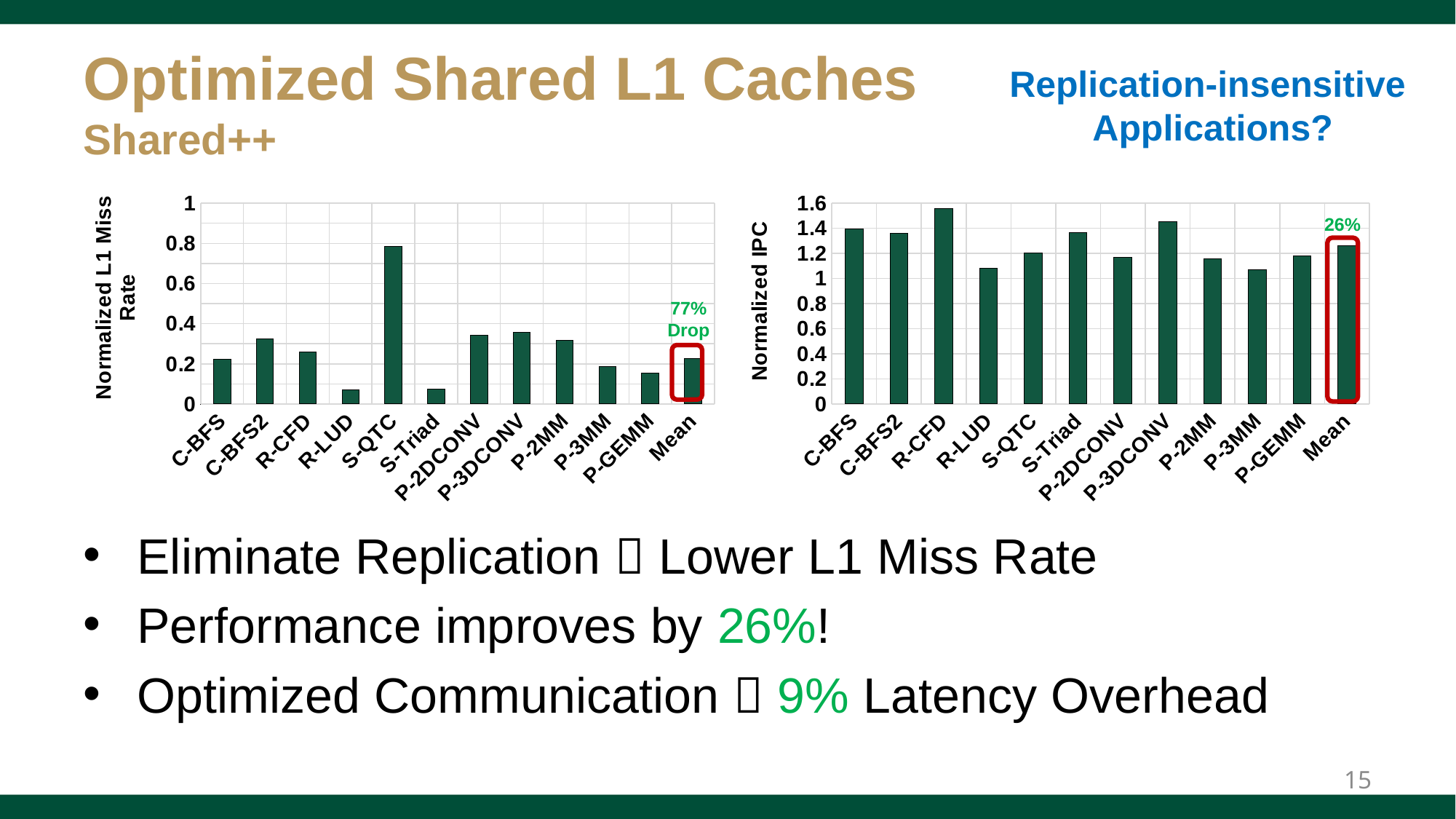
In the right chart (Normalized IPC), which is larger, the value for R-CFD or the value for P-3MM? R-CFD How many categories are shown on the x axis of the right chart (Normalized IPC)? 12 What kind of chart is the left chart (Normalized L1 Miss Rate)? bar chart In the right chart (Normalized IPC), is the value for R-LUD greater or less than 1.2? less In the right chart (Normalized IPC), which category has the highest value? R-CFD In the left chart (Normalized L1 Miss Rate), is the value for S-QTC greater or less than 0.6? greater What percentage is annotated above the Mean bar in the right chart (Normalized IPC)? 26% In the left chart (Normalized L1 Miss Rate), which is larger, the value for S-QTC or the value for C-BFS? S-QTC In the left chart (Normalized L1 Miss Rate), is the value for R-LUD greater or less than 0.2? less In the left chart (Normalized L1 Miss Rate), which category has the highest value? S-QTC